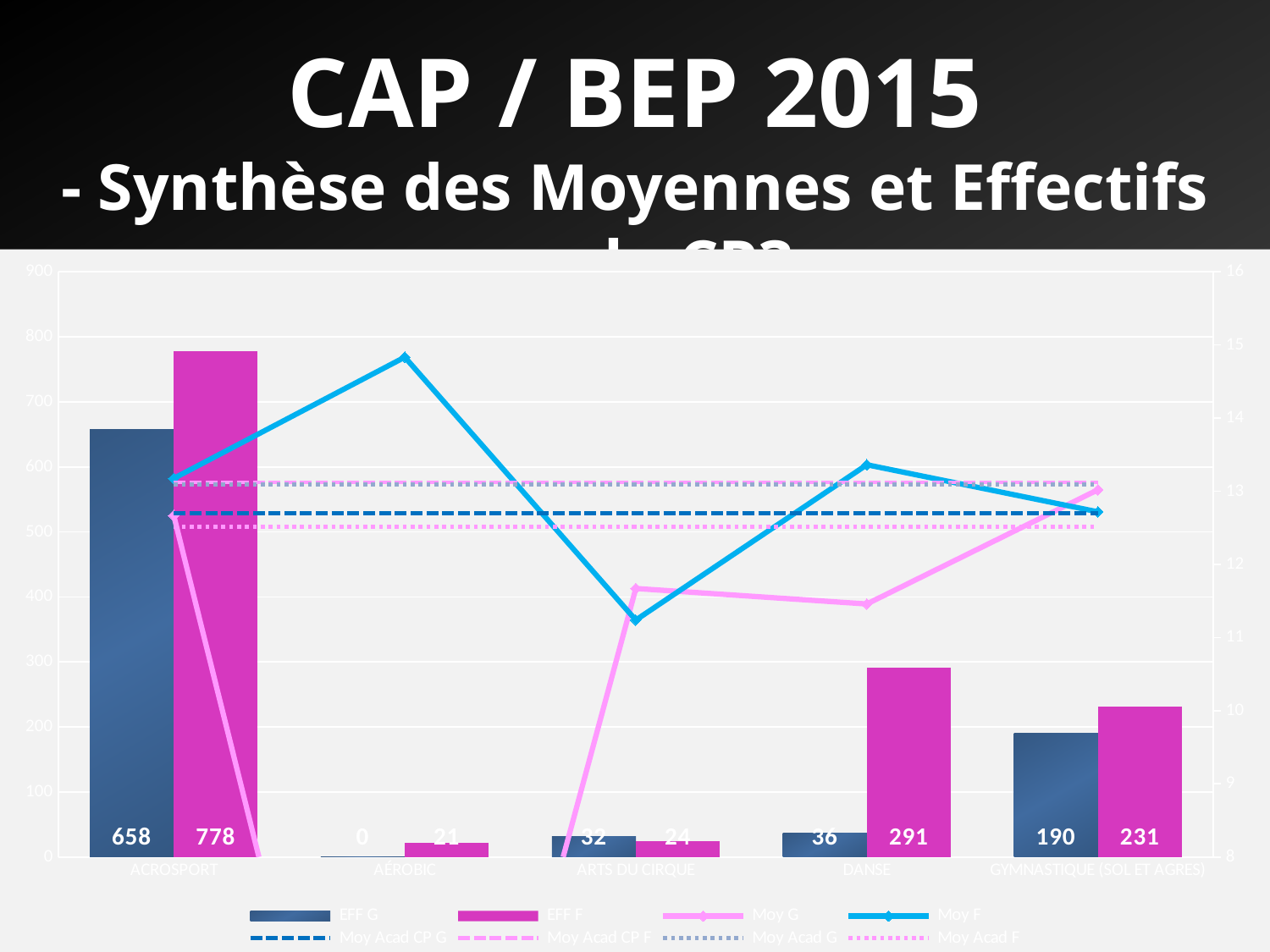
What is the difference between the EFF F and EFF G values for ACROSPORT? 120 Which category has the lowest EFF G value? AEROBIC What colour are the EFF F bars? Magenta What is the EFF F value for DANSE? 291 How many categories are shown on the x axis? 5 What is the EFF G value for ACROSPORT? 658 Which category has the highest EFF F value? ACROSPORT Is the Moy F value for AEROBIC greater or less than 14 on the right axis? greater What is the EFF G value for GYMNASTIQUE (SOL ET AGRES)? 190 Which is larger for ARTS DU CIRQUE, EFF G or EFF F? EFF G How many series does the legend list? 8 What is the EFF F value for AEROBIC? 21